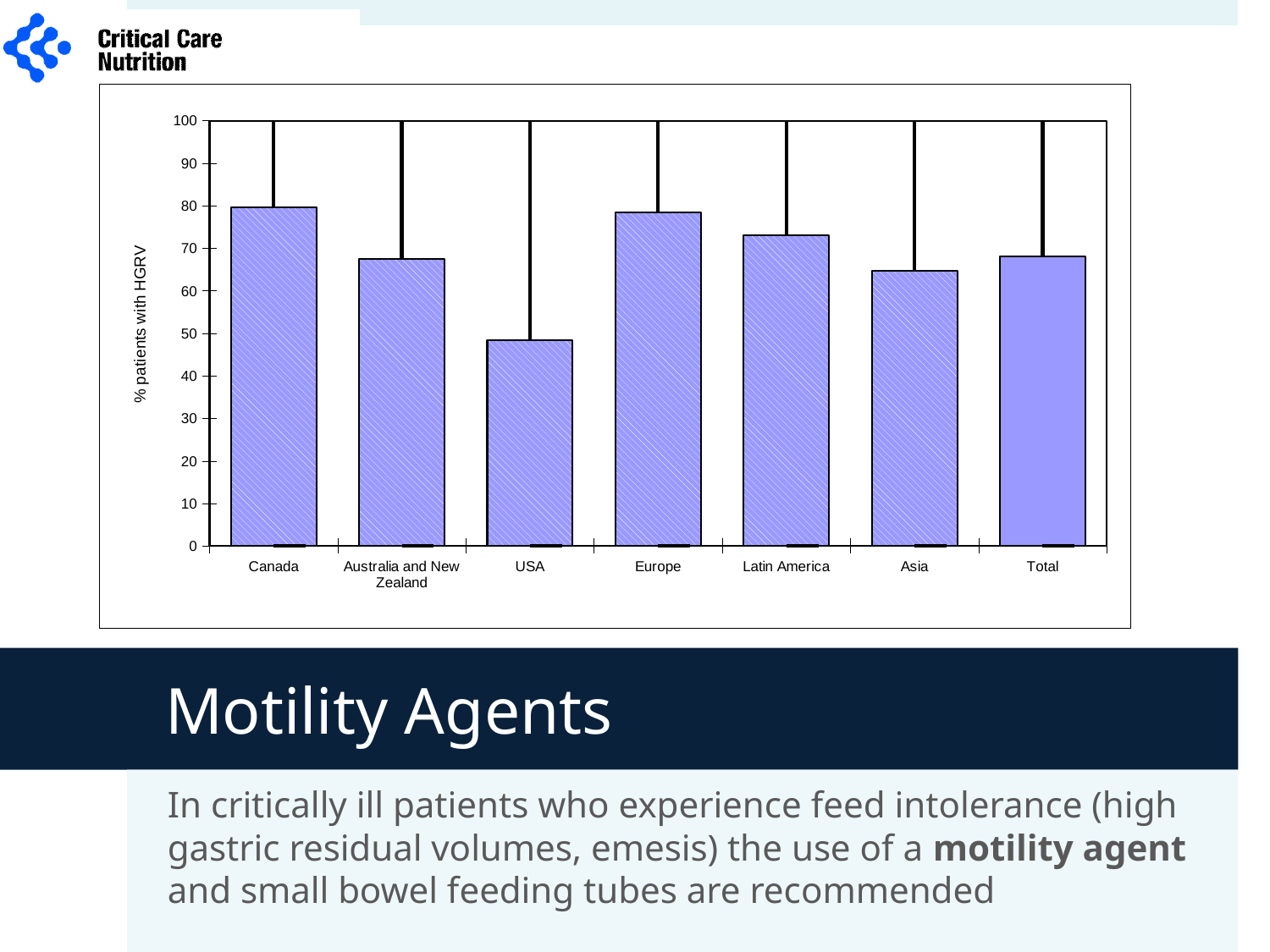
Which has a higher % patients with HGRV, Canada or USA? Canada Is the value for USA greater or less than 60? less Is the value for Asia greater or less than 60? greater Is the value for Canada greater or less than 70? greater How many categories are shown on the x axis of the chart? 7 What is the label on the y axis of the chart? % patients with HGRV Which category has the lowest % patients with HGRV? USA Which has a higher % patients with HGRV, Latin America or Asia? Latin America What kind of chart is shown on the slide? bar chart